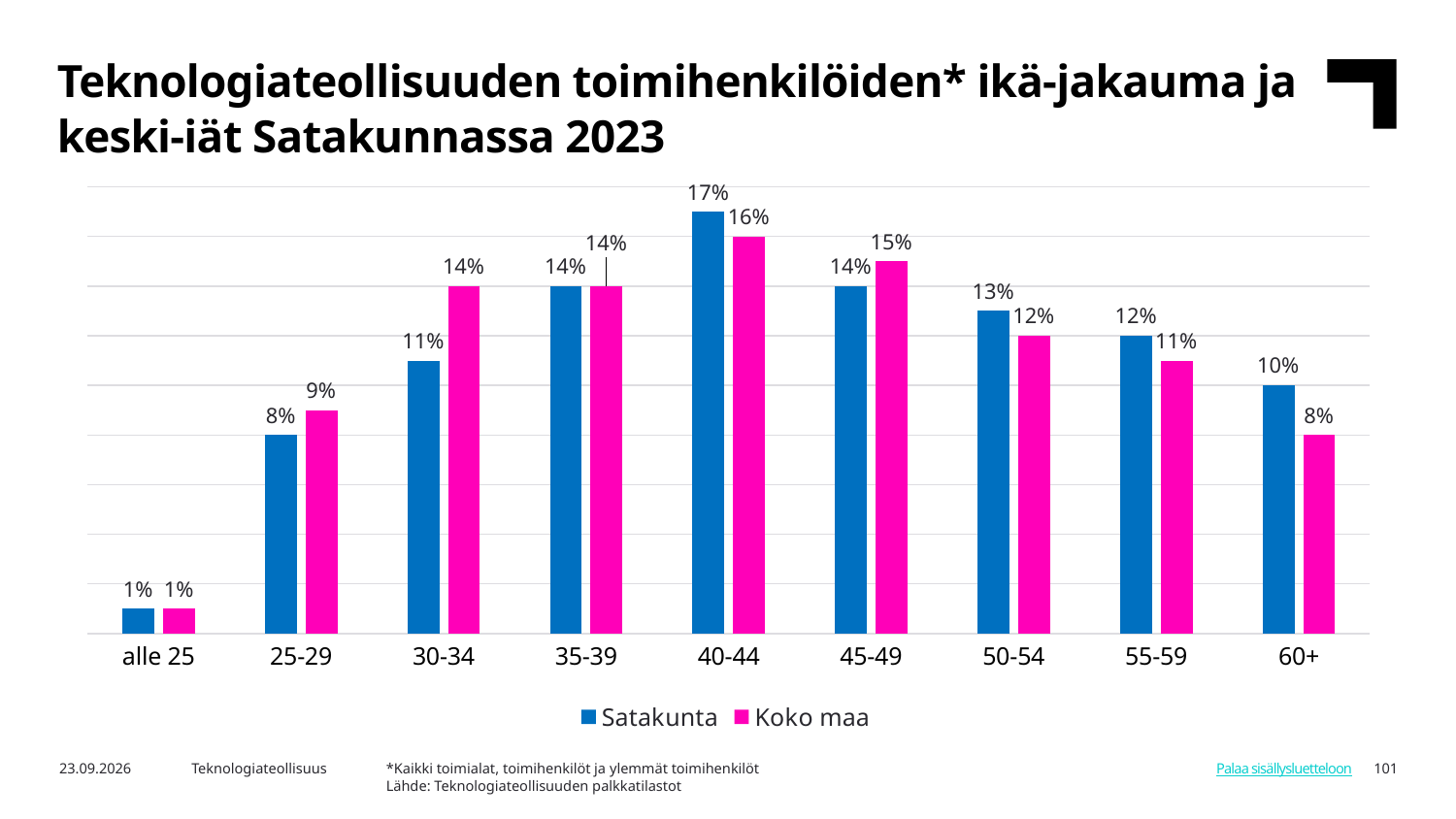
In the 45-49 age group, which series has the larger value, Satakunta or Koko maa? Koko maa Which series is shown in magenta? Koko maa What kind of chart is shown on the slide? Bar chart How many age groups are shown on the x axis? 9 What is the value for Satakunta in the 40-44 age group? 17% What is the value for Koko maa in the 60+ age group? 8% Which age group has the highest value for Satakunta? 40-44 What is the difference between the Satakunta and Koko maa values in the 30-34 age group? 3% In the 50-54 age group, which series has the larger value, Satakunta or Koko maa? Satakunta How many series does the legend list? 2 What is the value for Koko maa in the 25-29 age group? 9% Which age group has the lowest value for Koko maa? alle 25